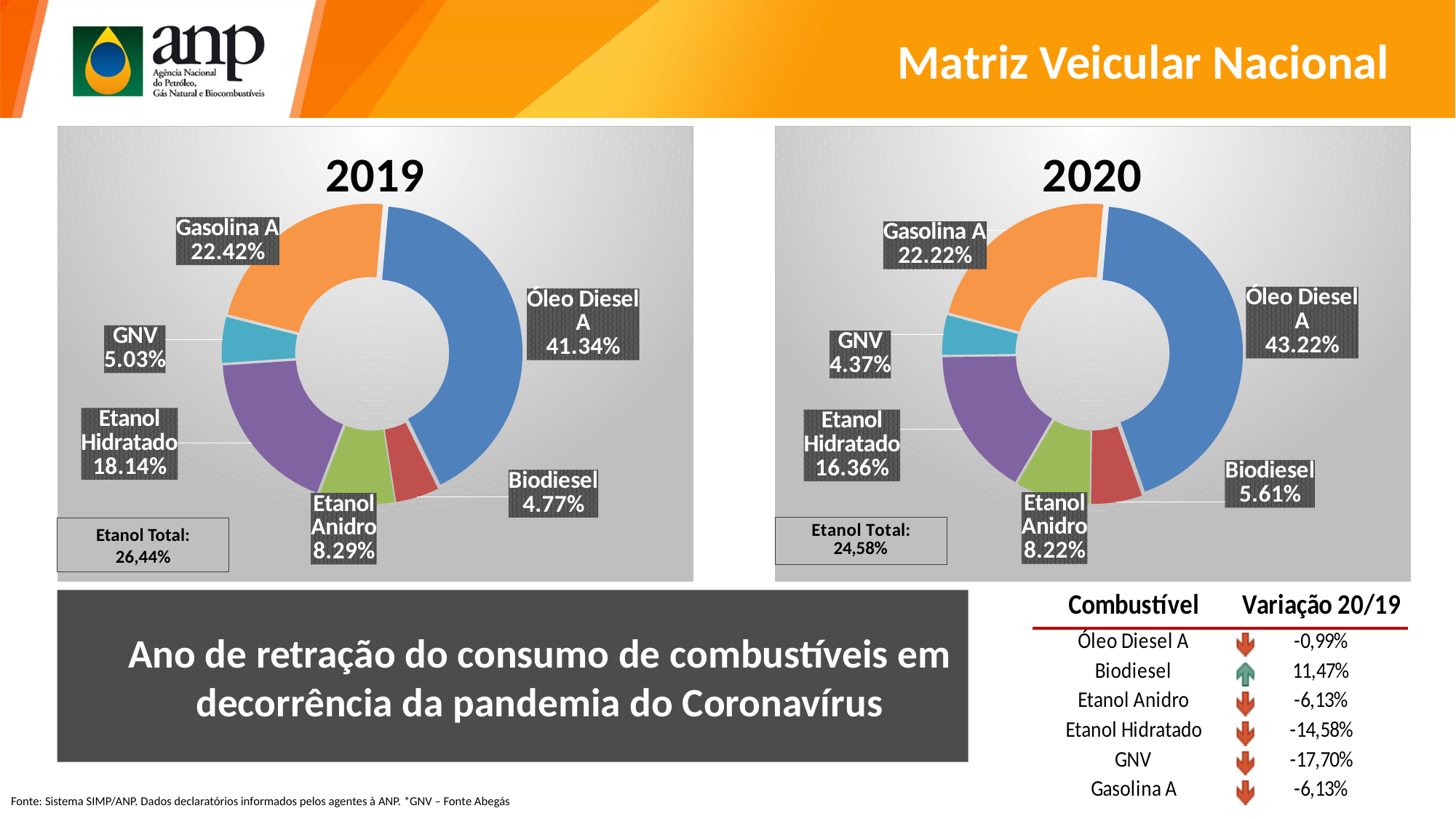
In the 2019 chart, which is larger: GNV or Biodiesel? GNV In the 2019 chart, what share does Óleo Diesel A have? 41.34% In the 2020 chart, which is larger: Biodiesel or GNV? Biodiesel In the 2019 chart, which fuel has the largest share? Óleo Diesel A In the 2020 chart, what share does Gasolina A have? 22.22% In the 2020 chart, what is the value for GNV? 4.37% How many fuel categories are shown in the 2020 chart? 6 In the 2019 chart, which fuel has the smallest share? Biodiesel In the 2019 chart, what is the difference between Etanol Hidratado and Etanol Anidro? 9.85% What type of chart is used for the 2019 data? Pie (doughnut) chart In the 2020 chart, what is the difference between the shares of Óleo Diesel A and Gasolina A? 21.00% In the 2020 chart, which fuel has the smallest share? GNV